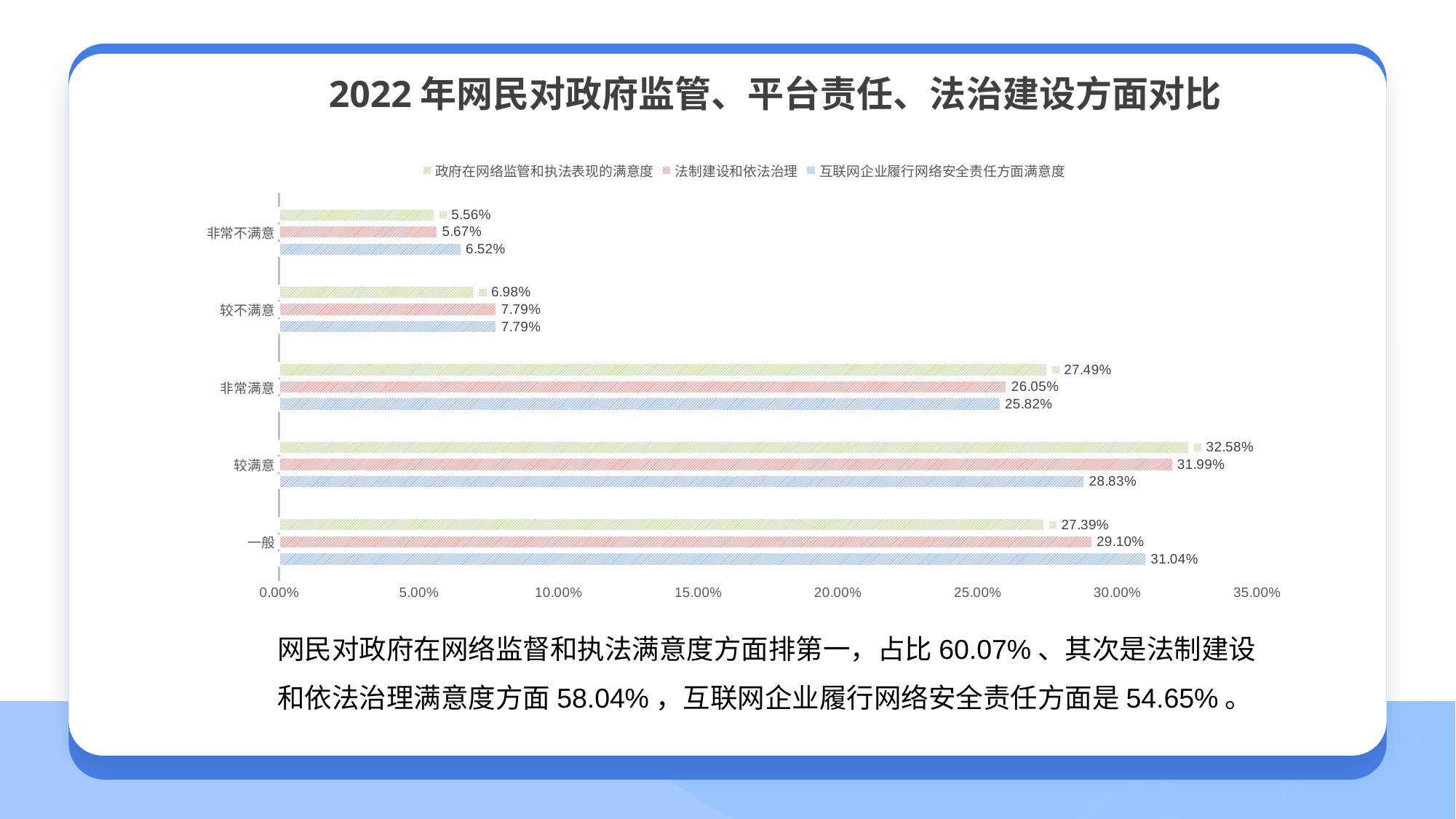
Which category has the lowest value in the 互联网企业履行网络安全责任方面满意度 series? 非常不满意 Is the value for 非常满意 in the 互联网企业履行网络安全责任方面满意度 series greater or less than 25.00%? greater How many series does the legend list? 3 What is the title of the chart? 2022 年网民对政府监管、平台责任、法治建设方面对比 What is the value for 非常满意 in the 法制建设和依法治理 series? 26.05% What is the value for 较满意 in the 政府在网络监管和执法表现的满意度 series? 32.58% For the category 一般, which series has the larger value: 法制建设和依法治理 or 政府在网络监管和执法表现的满意度? 法制建设和依法治理 What is the value for 一般 in the 互联网企业履行网络安全责任方面满意度 series? 31.04% Which category has the highest value in the 政府在网络监管和执法表现的满意度 series? 较满意 How many categories are shown on the vertical axis? 5 What type of chart is shown on the slide? Bar chart What is the difference between the 较满意 values of the 政府在网络监管和执法表现的满意度 series and the 互联网企业履行网络安全责任方面满意度 series? 3.75%